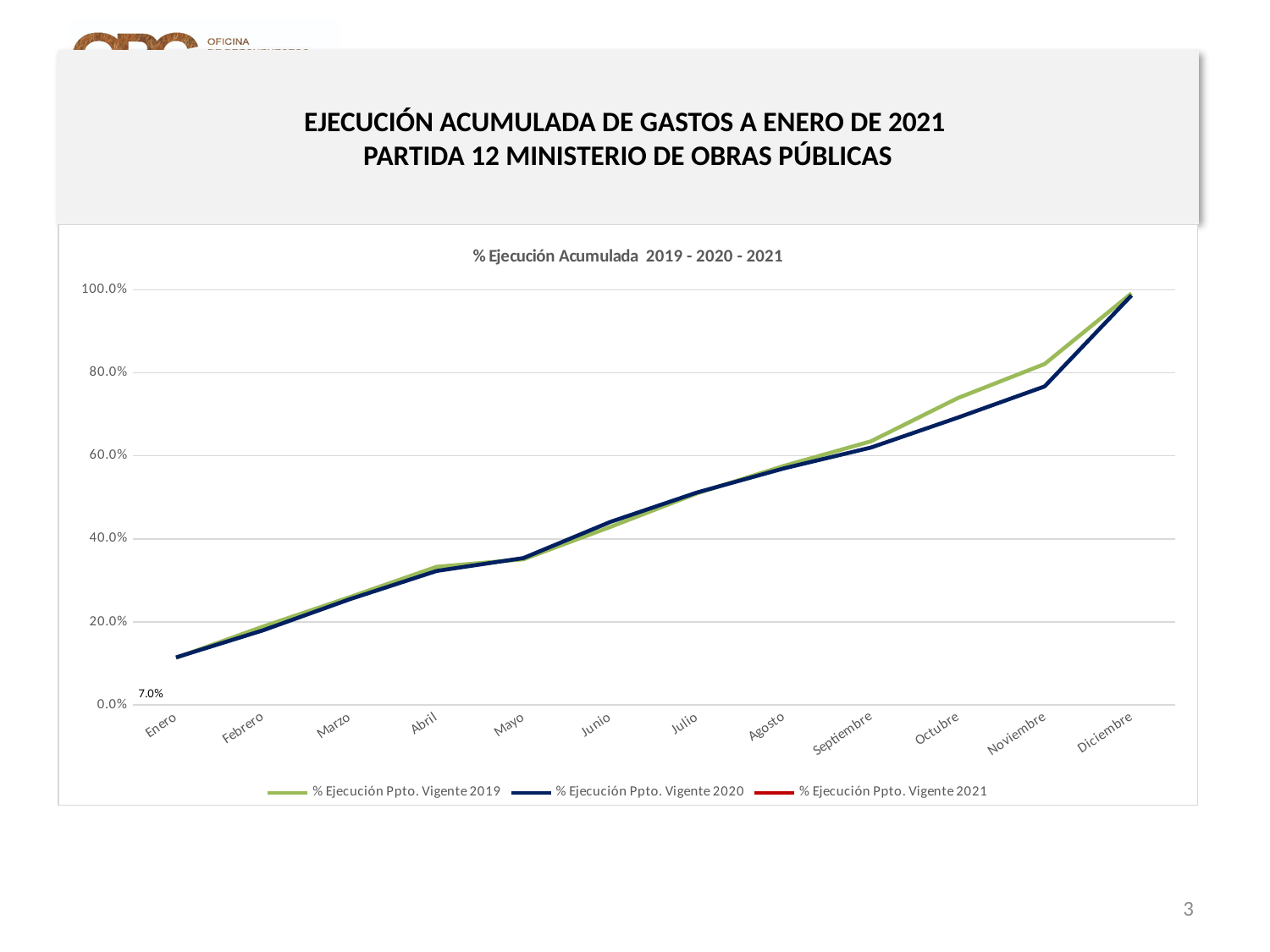
Is the value for % Ejecución Ppto. Vigente 2019 in Octubre greater or less than 80.0%? less Do the values for % Ejecución Ppto. Vigente 2020 rise or fall from Enero to Diciembre? rise In which month does % Ejecución Ppto. Vigente 2019 reach its highest value? Diciembre How many months are shown along the x axis? 12 What is the title of the chart? % Ejecución Acumulada 2019 - 2020 - 2021 What kind of chart is shown on the slide? line chart Is the value for % Ejecución Ppto. Vigente 2020 in Enero greater or less than 20.0%? less How many series does the legend list? 3 Is the value for % Ejecución Ppto. Vigente 2019 in Diciembre greater or less than 80.0%? greater What is the value of % Ejecución Ppto. Vigente 2021 for Enero? 7.0% In Noviembre, which series is higher: % Ejecución Ppto. Vigente 2019 or % Ejecución Ppto. Vigente 2020? % Ejecución Ppto. Vigente 2019